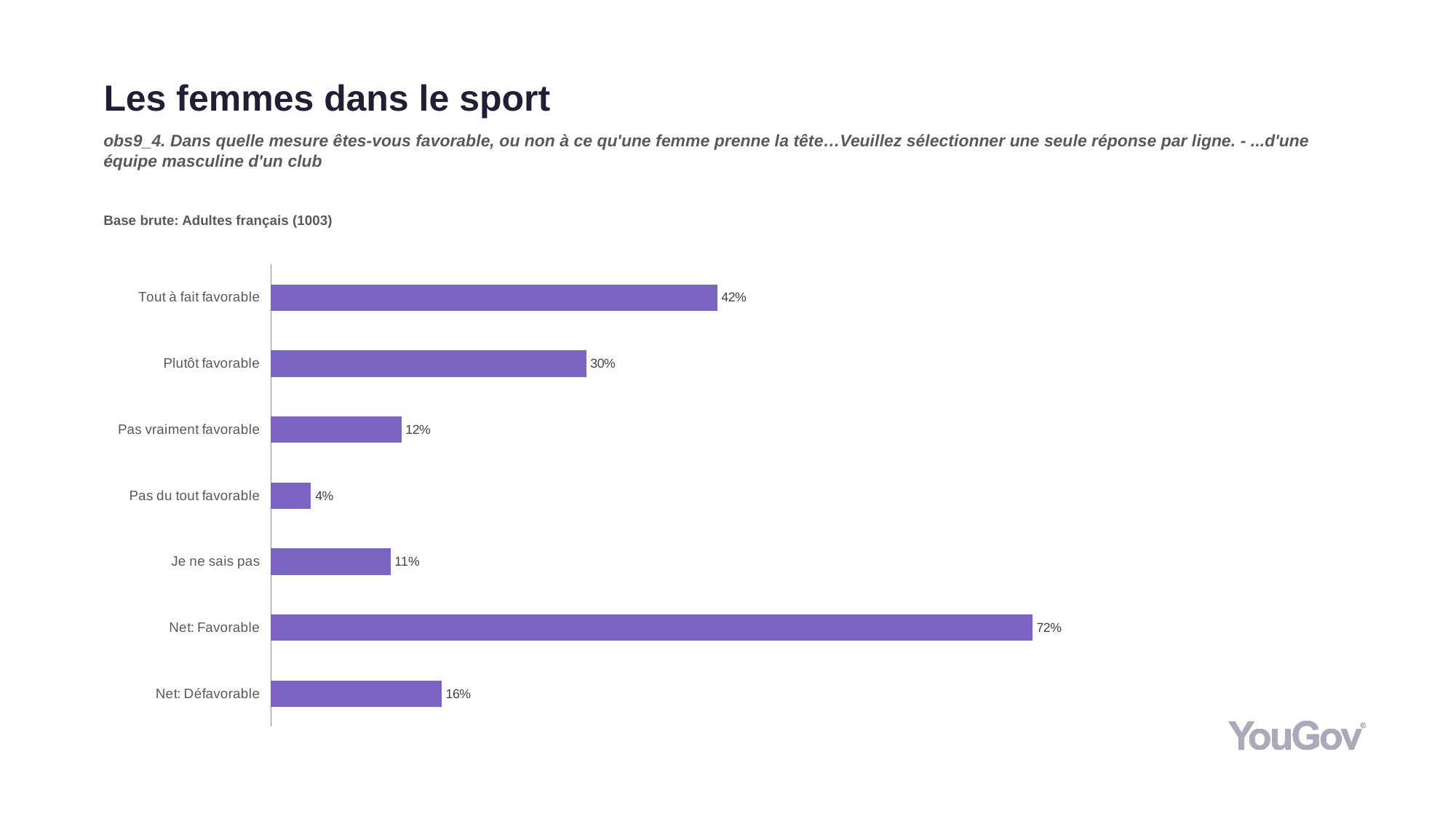
What is the base (sample) stated on the slide? Adultes français (1003) Which category has the lowest value? Pas du tout favorable What is the difference between "Tout à fait favorable" and "Plutôt favorable"? 12% How many categories are shown in the chart? 7 Which is larger, "Pas vraiment favorable" or "Je ne sais pas"? Pas vraiment favorable What kind of chart is shown on the slide? Bar chart What is the value for "Plutôt favorable"? 30% Which category has the highest value? Net: Favorable What is the value for "Pas du tout favorable"? 4% What is the value for "Net: Défavorable"? 16% What is the difference between "Net: Favorable" and "Net: Défavorable"? 56% What is the value for "Tout à fait favorable"? 42%